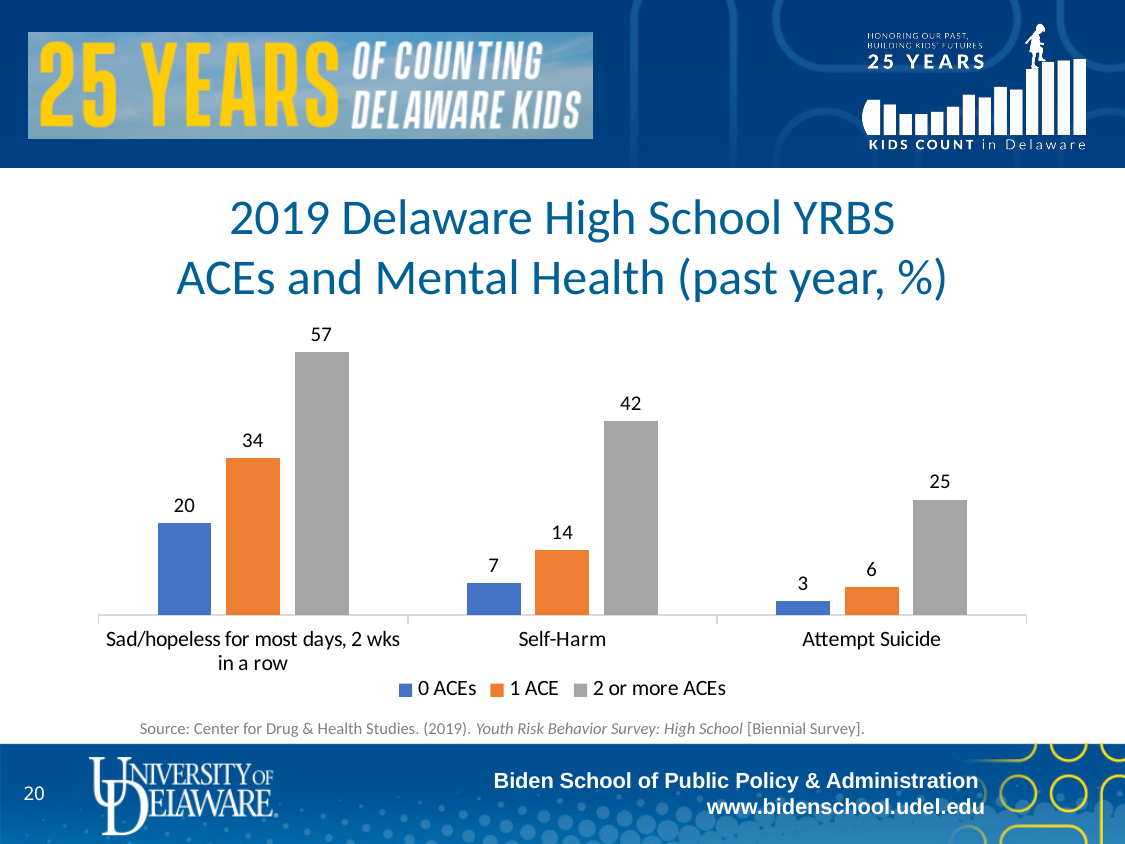
What is the value for 0 ACEs in the Self-Harm category? 7 Which category has the lowest value for 0 ACEs? Attempt Suicide How many series does the legend list? 3 How many categories are shown on the x axis? 3 What is the difference between the 2 or more ACEs and 0 ACEs values in the Self-Harm category? 35 Which category has the highest value for 2 or more ACEs? Sad/hopeless for most days, 2 wks in a row Which is larger: the 1 ACE value for Self-Harm or the 0 ACEs value for Sad/hopeless for most days, 2 wks in a row? 0 ACEs value for Sad/hopeless for most days, 2 wks in a row What kind of chart is shown on the slide? Bar chart What is the value for 2 or more ACEs in the Sad/hopeless for most days, 2 wks in a row category? 57 What is the difference between the 1 ACE values for Sad/hopeless for most days, 2 wks in a row and Attempt Suicide? 28 What is the value for 1 ACE in the Attempt Suicide category? 6 Which series is shown in gray in the legend? 2 or more ACEs